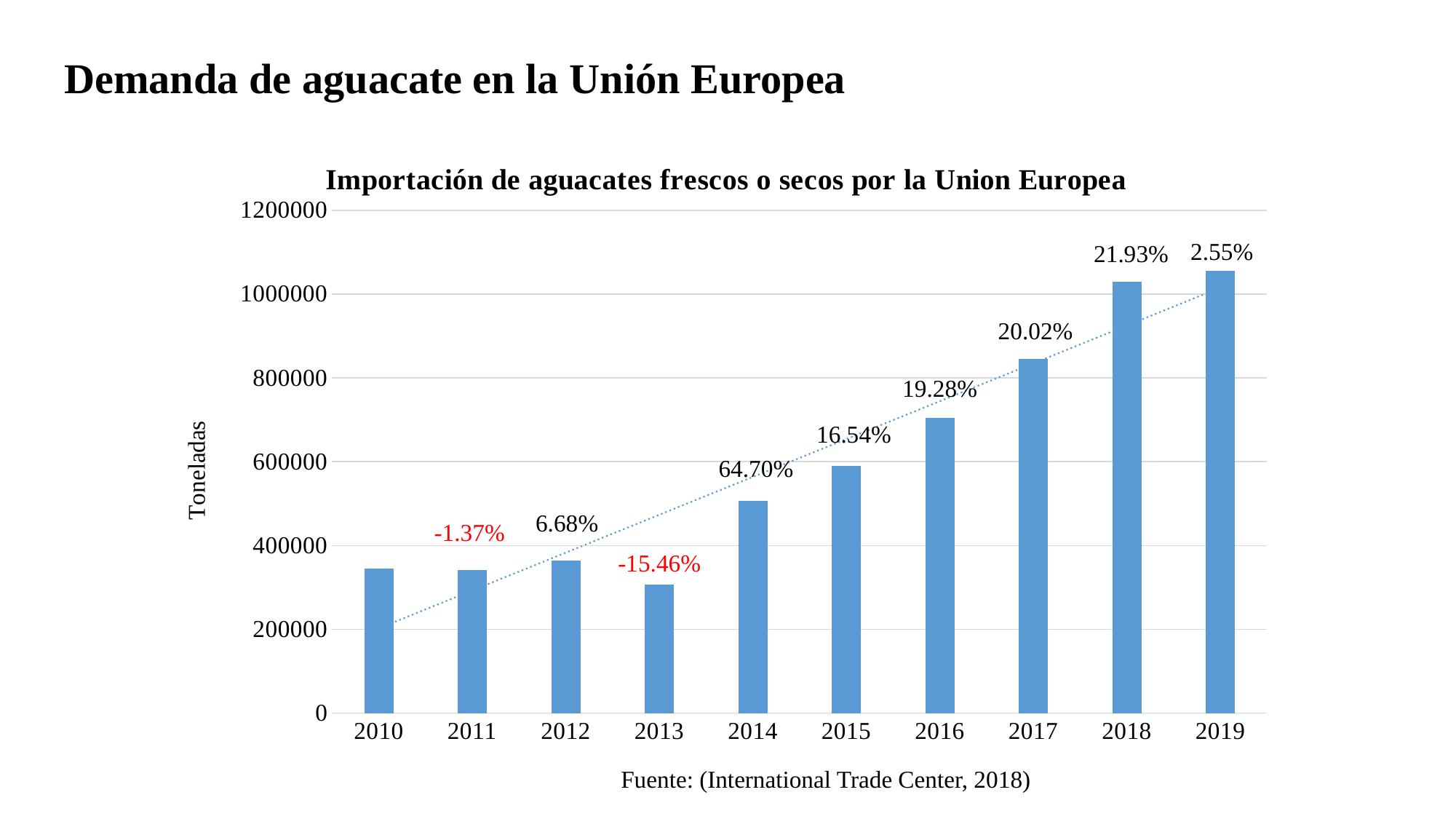
What percentage label is shown above the 2013 bar? -15.46% What percentage label is shown above the 2014 bar? 64.70% How many years are plotted on the x axis of the chart? 10 What percentage label is shown above the 2018 bar? 21.93% Which year has the larger import value, 2012 or 2013? 2012 Which year has the highest import value in the chart? 2019 What kind of chart is shown on the slide? bar chart Do the import values generally rise or fall from 2013 to 2019? rise What is the label on the vertical axis of the chart? Toneladas Which year has the lowest import value in the chart? 2013 Is the value for 2010 greater or less than 400000? less Is the value for 2017 greater or less than 800000? greater